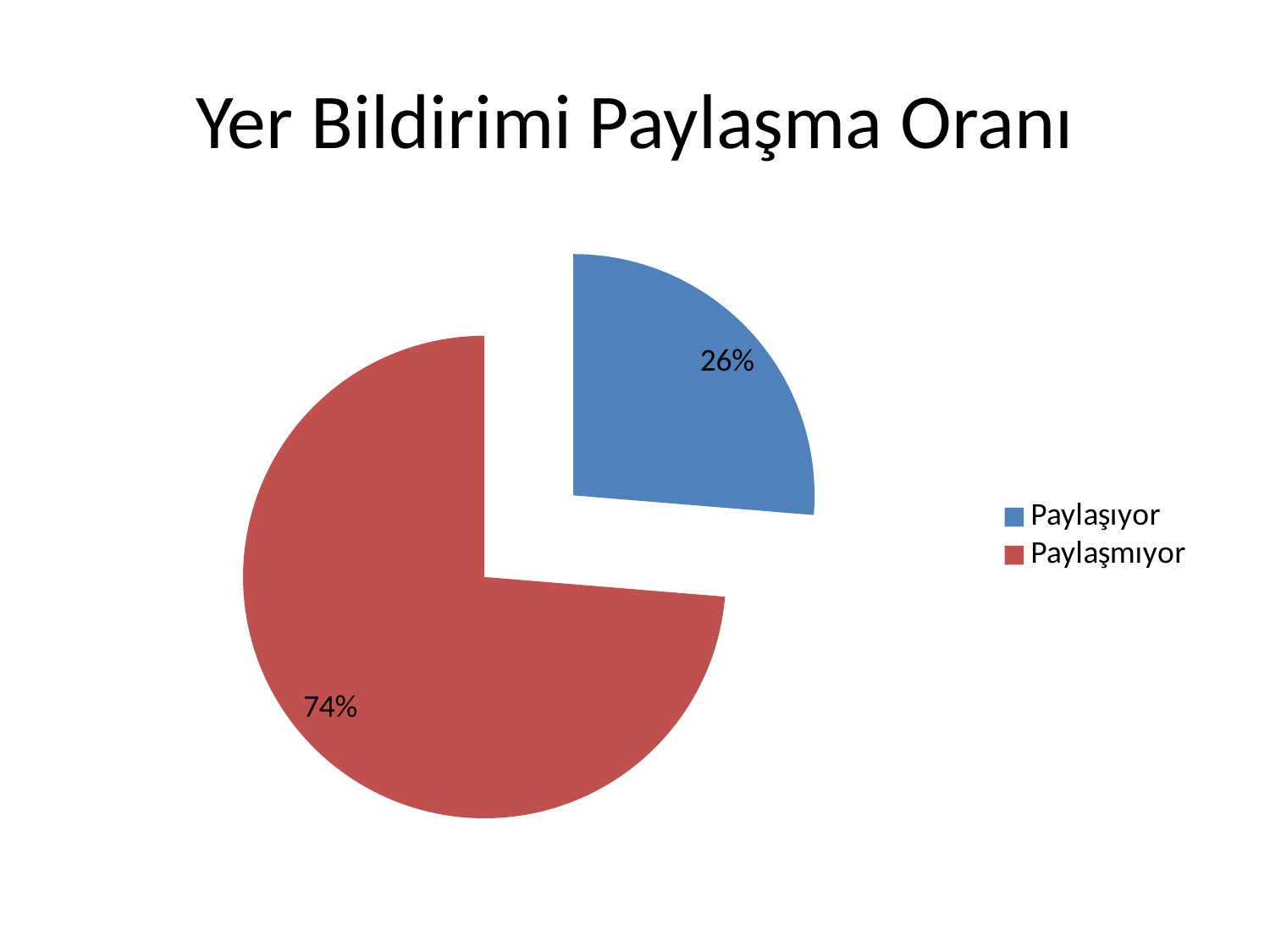
What is the difference in percentage points between Paylaşmıyor and Paylaşıyor? 48 How many entries does the legend list? 2 What kind of chart is shown on the slide? pie chart What is the title of the chart? Yer Bildirimi Paylaşma Oranı Which is larger, the Paylaşıyor slice or the Paylaşmıyor slice? Paylaşmıyor Which category has the largest slice of the pie? Paylaşmıyor What share of the pie does Paylaşmıyor represent? 74% What share of the pie does Paylaşıyor represent? 26% Is the share for Paylaşıyor greater or less than 50%? less How many slices does the pie chart have? 2 What colour is the Paylaşıyor slice? blue Which category has the smallest slice of the pie? Paylaşıyor